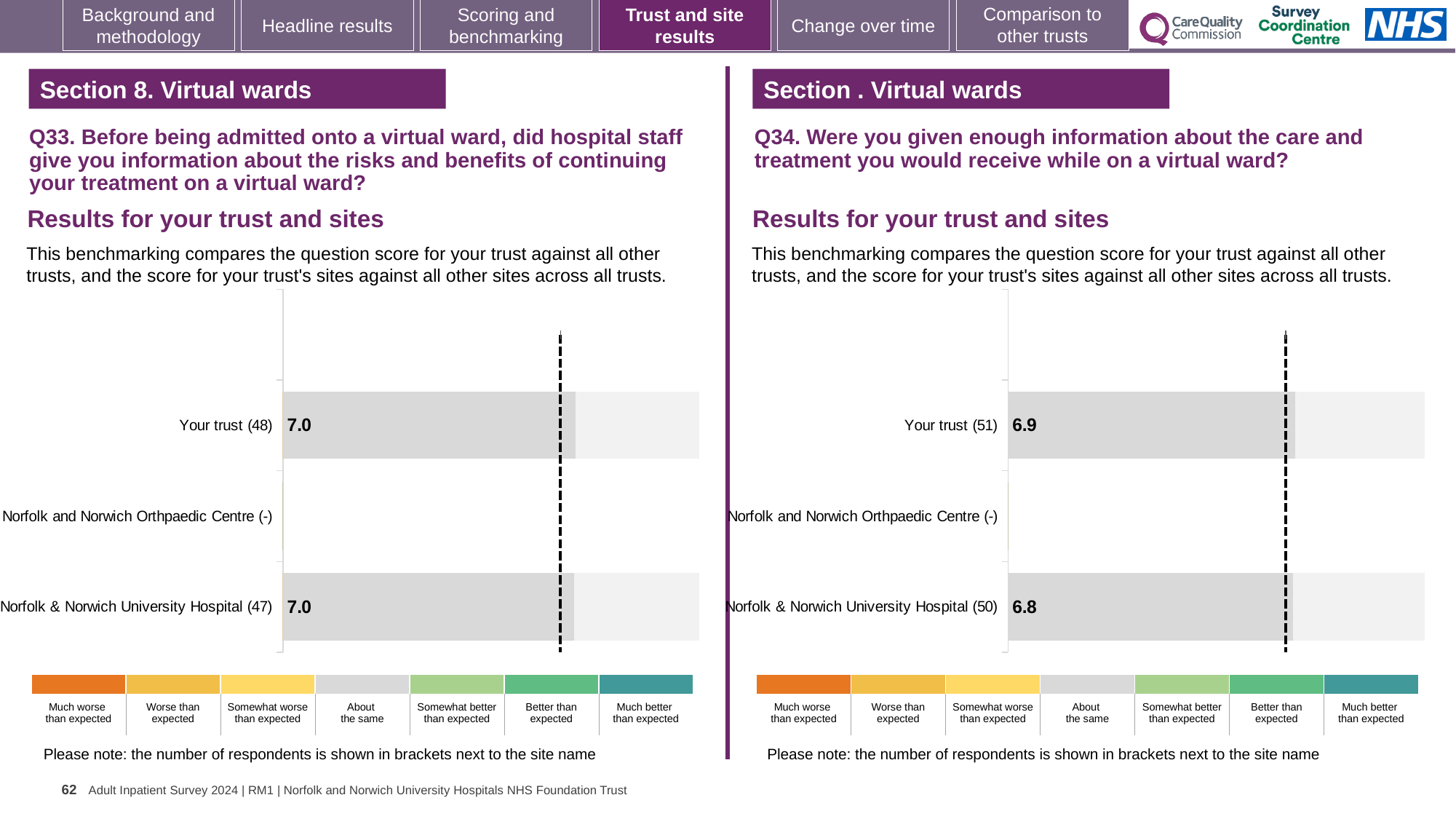
In the Q34 chart on the right, which has the higher score: Your trust (51) or Norfolk & Norwich University Hospital (50)? Your trust (51) In the Q33 chart on the left, what is the difference between the score for Your trust (48) and the score for Norfolk & Norwich University Hospital (47)? 0.0 In the Q34 chart on the right, what is the score for Your trust (51)? 6.9 What kind of chart is the Q34 chart on the right? Bar chart In the Q34 chart on the right, how many respondents are shown in brackets for Norfolk & Norwich University Hospital? 50 In the Q33 chart on the left, what is the score for Your trust (48)? 7.0 In the Q33 chart on the left, what is the score for Norfolk & Norwich University Hospital (47)? 7.0 In the Q34 chart on the right, what is the difference between the score for Your trust (51) and the score for Norfolk & Norwich University Hospital (50)? 0.1 In the Q34 chart on the right, what is the score for Norfolk & Norwich University Hospital (50)? 6.8 How many benchmark categories does the colour legend below the Q33 chart on the left list? 7 How many categories (rows) are listed on the y axis of the Q33 chart on the left? 3 In the legend below the Q34 chart on the right, which category is shown in orange at the far left? Much worse than expected